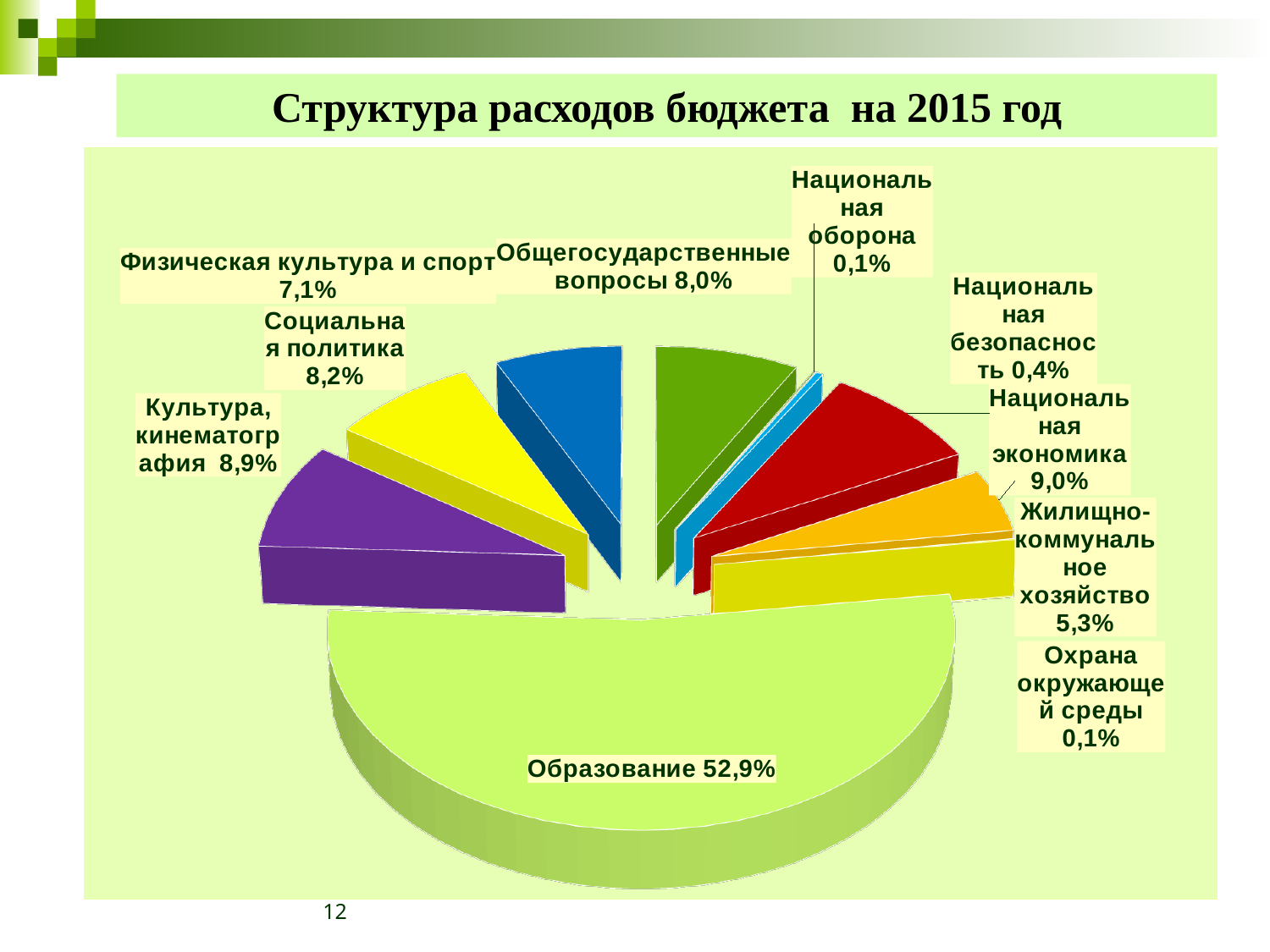
What is the share of Национальная экономика? 9,0% What is the difference between the share of Национальная экономика and the share of Общегосударственные вопросы? 1,0% What is the share of Жилищно-коммунальное хозяйство? 5,3% What is the share of Национальная безопасность? 0,4% Which is larger, the share of Культура, кинематография or the share of Физическая культура и спорт? Культура, кинематография What kind of chart is shown on the slide? Pie chart How many categories are shown in the pie chart? 10 What is the difference between the share of Социальная политика and the share of Жилищно-коммунальное хозяйство? 2,9% What is the title of the slide's chart? Структура расходов бюджета на 2015 год Which category has the smallest share, Национальная безопасность or Национальная оборона? Национальная оборона What is the share of Образование in the 2015 budget expenditure structure? 52,9% Which category has the largest share of the budget expenditure? Образование